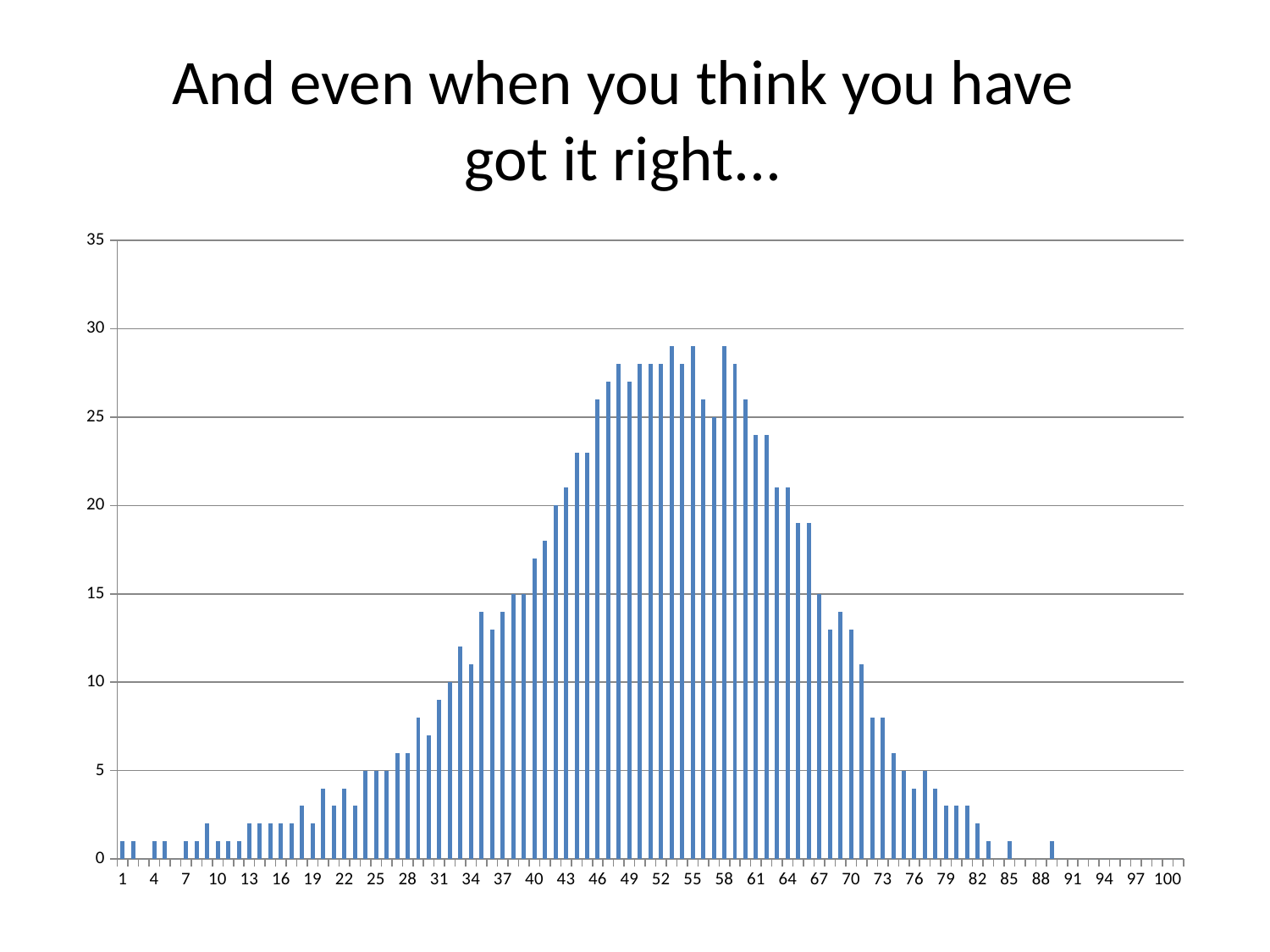
Is the value for category 36 greater or less than 10? greater Is the value for category 1 greater or less than 5? less Which has the larger value, category 48 or category 10? 48 Which has the larger value, category 25 or category 65? 65 Is the value for category 53 greater or less than 25? greater Do the values generally rise or fall from category 60 to category 100? fall Do the values generally rise or fall from category 1 to category 40? rise What is the highest value shown on the y axis? 35 What kind of chart is shown on the slide? bar chart